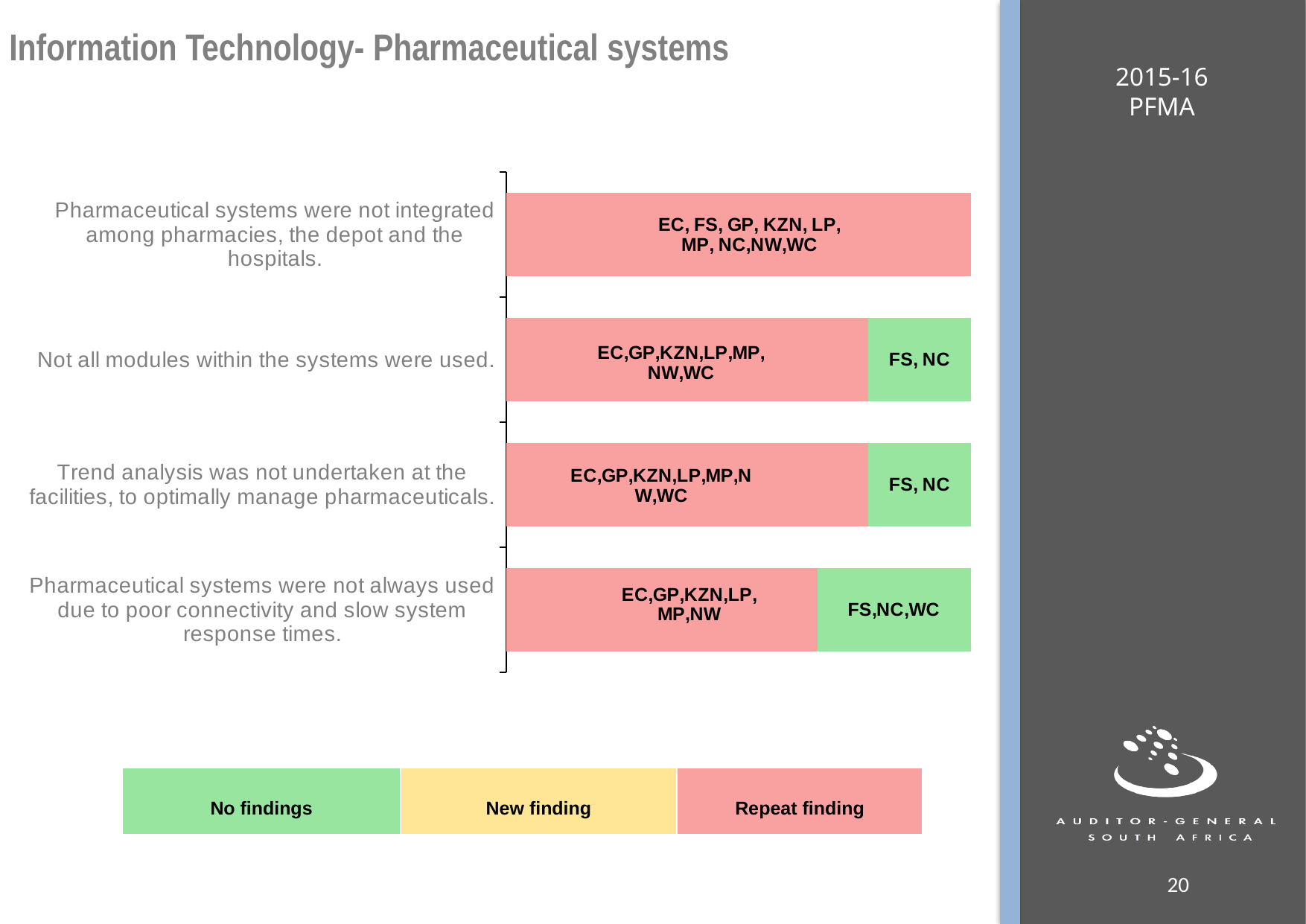
Which finding has no 'No findings' segment at all? Pharmaceutical systems were not integrated among pharmacies, the depot and the hospitals. How many entries does the legend at the bottom of the chart list? 3 What is the title of the slide containing the chart? Information Technology- Pharmaceutical systems Which provinces are listed in the 'No findings' segment for 'Trend analysis was not undertaken at the facilities, to optimally manage pharmaceuticals.'? FS, NC Which finding has more provinces with no findings: 'Not all modules within the systems were used.' or 'Pharmaceutical systems were not always used due to poor connectivity and slow system response times.'? Pharmaceutical systems were not always used due to poor connectivity and slow system response times. What kind of chart is shown on the slide? Bar chart Which provinces are listed in the 'No findings' segment for 'Not all modules within the systems were used.'? FS, NC Which provinces are listed in the 'No findings' segment for 'Pharmaceutical systems were not always used due to poor connectivity and slow system response times.'? FS,NC,WC Which colour represents 'New finding' in the legend? Yellow Which provinces are listed in the 'Repeat finding' segment for 'Pharmaceutical systems were not integrated among pharmacies, the depot and the hospitals.'? EC, FS, GP, KZN, LP, MP, NC,NW,WC Which provinces are listed in the 'Repeat finding' segment for 'Not all modules within the systems were used.'? EC,GP,KZN,LP,MP,NW,WC How many findings (categories) are plotted in the chart? 4